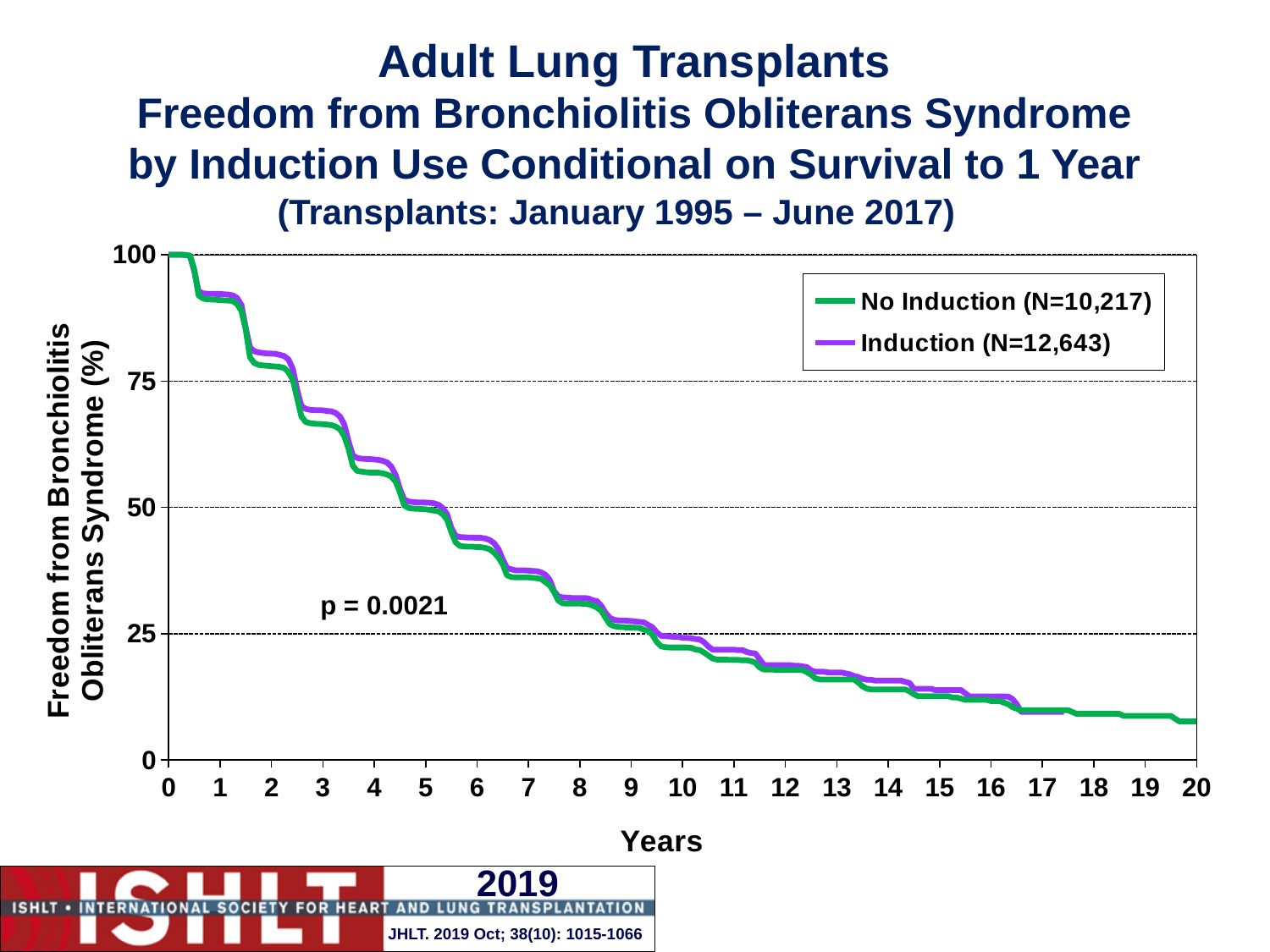
What is the N for the Induction group shown in the legend? 12,643 How many series does the legend list? 2 Is the value for the No Induction series at year 10 greater or less than 25? less Is the value for the Induction series at year 15 greater or less than 25? less Is the value for the No Induction series at year 3 greater or less than 50? greater What is the N for the No Induction group shown in the legend? 10,217 What is the p-value printed on the chart? p = 0.0021 What is the freedom from bronchiolitis obliterans syndrome for both groups at year 0? 100 What kind of chart is shown on the slide? line chart Do the values for the Induction series rise or fall as years increase? fall